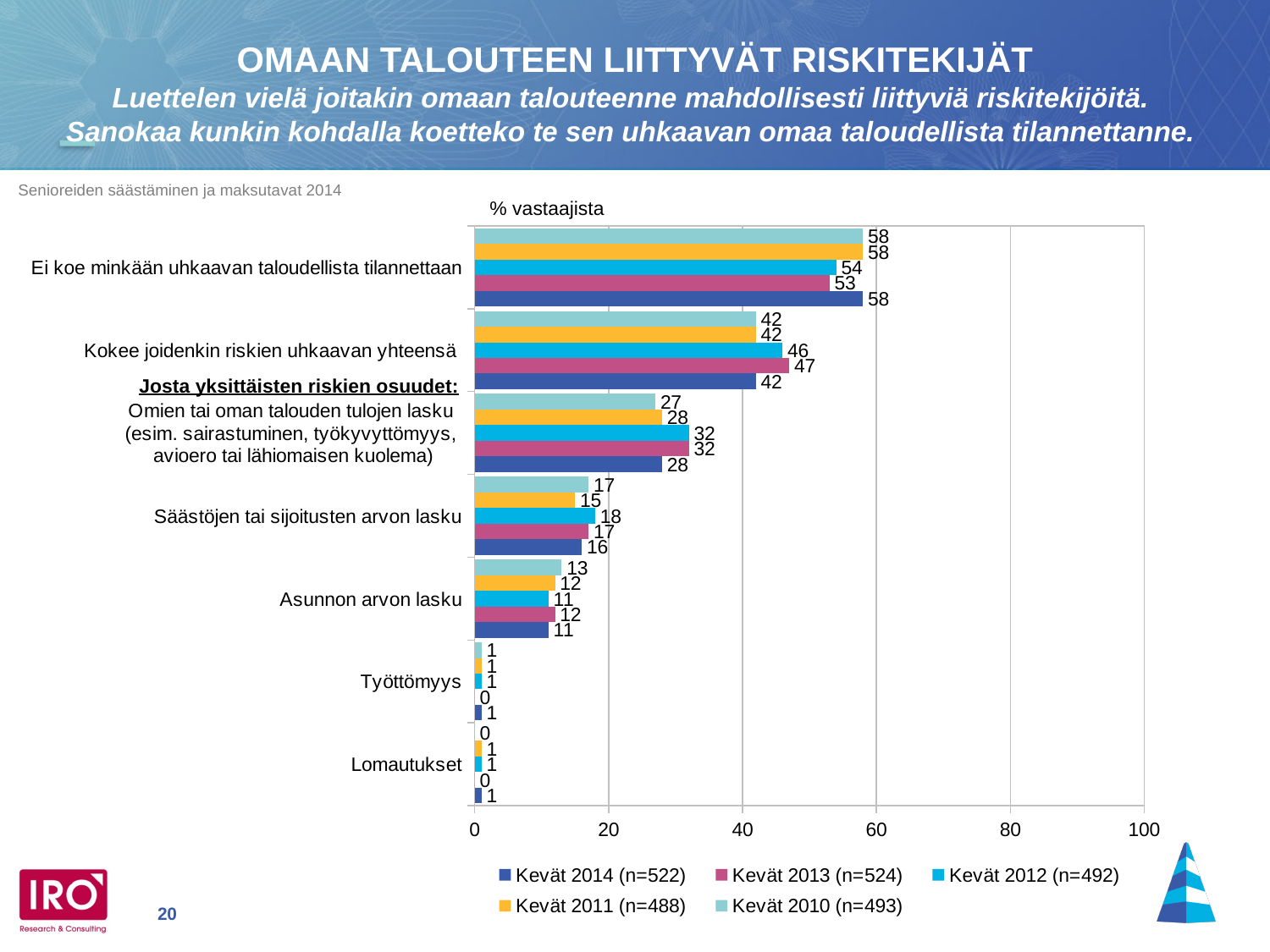
What is the difference between the Kevät 2013 (n=524) and Kevät 2014 (n=522) values for "Kokee joidenkin riskien uhkaavan yhteensä"? 5 How many categories are shown on the chart? 7 What is the value for Kevät 2014 (n=522) in the category "Ei koe minkään uhkaavan taloudellista tilannettaan"? 58 What kind of chart is shown on the slide? bar chart What is the label on the value axis of the chart? % vastaajista Which category has the highest value for Kevät 2014 (n=522)? Ei koe minkään uhkaavan taloudellista tilannettaan Is the Kevät 2013 (n=524) value for "Ei koe minkään uhkaavan taloudellista tilannettaan" greater or less than 40? greater For "Omien tai oman talouden tulojen lasku", which is larger: the Kevät 2012 (n=492) value or the Kevät 2011 (n=488) value? Kevät 2012 (n=492) What is the value for Kevät 2013 (n=524) in the category "Kokee joidenkin riskien uhkaavan yhteensä"? 47 What is the value for Kevät 2010 (n=493) in the category "Asunnon arvon lasku"? 13 What is the value for Kevät 2012 (n=492) in the category "Säästöjen tai sijoitusten arvon lasku"? 18 How many series does the legend list? 5